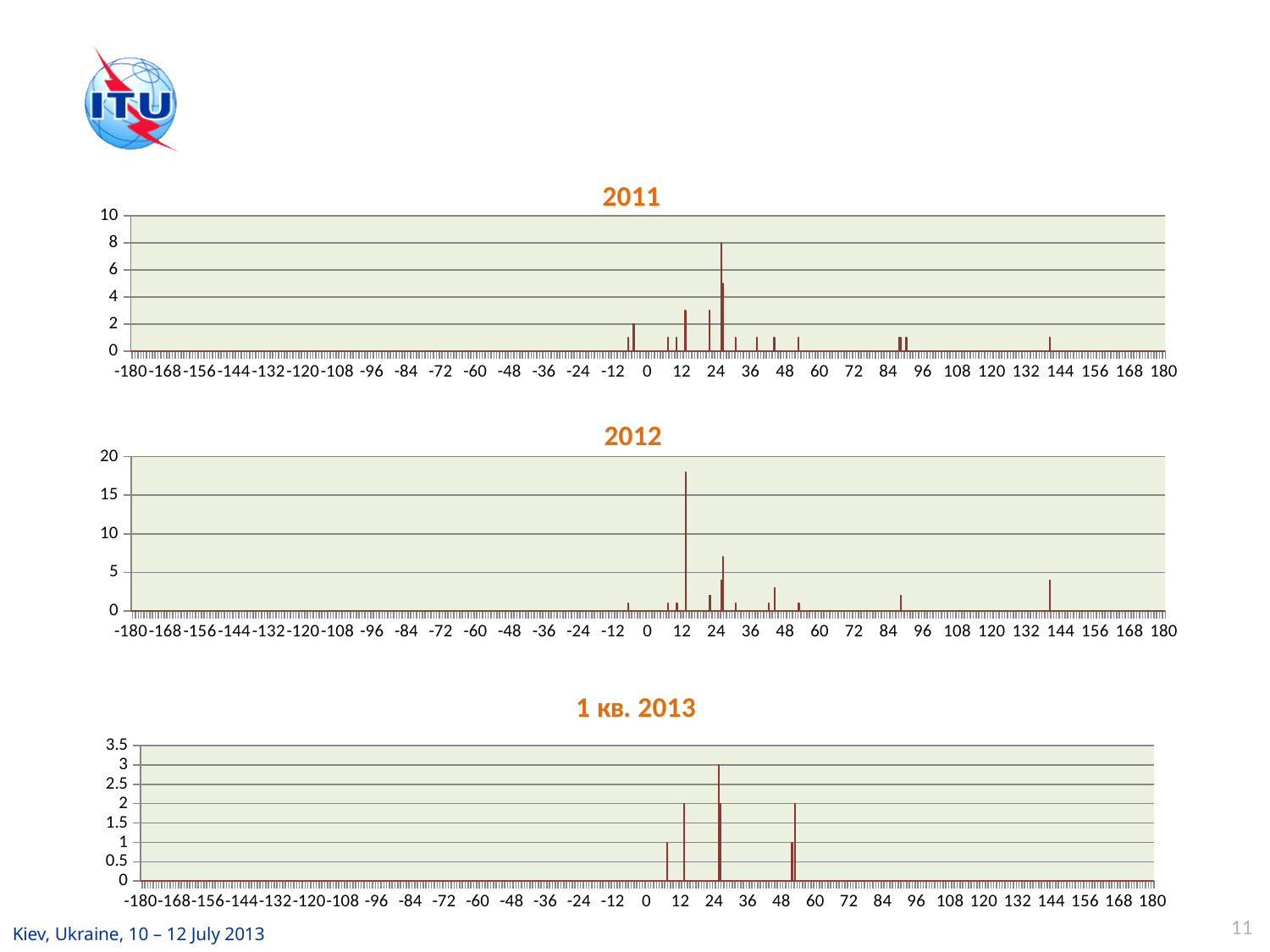
In the chart titled 1 кв. 2013, what value does the tallest bar reach? 3 What is the title of the bottom chart on the slide? 1 кв. 2013 In the chart titled 2012, is the bar near 144 on the x axis greater or less than 5? less What kind of chart is the chart titled 2011? bar chart In the chart titled 1 кв. 2013, is the tallest bar greater or less than 2.5? greater In the chart titled 2012, is the tallest bar greater or less than 15? greater Which chart has the taller tallest bar, the chart titled 2011 or the chart titled 2012? 2012 What is the highest value shown on the vertical axis of the chart titled 2012? 20 What kind of chart is the chart titled 1 кв. 2013? bar chart In the chart titled 2011, what value does the tallest bar reach? 8